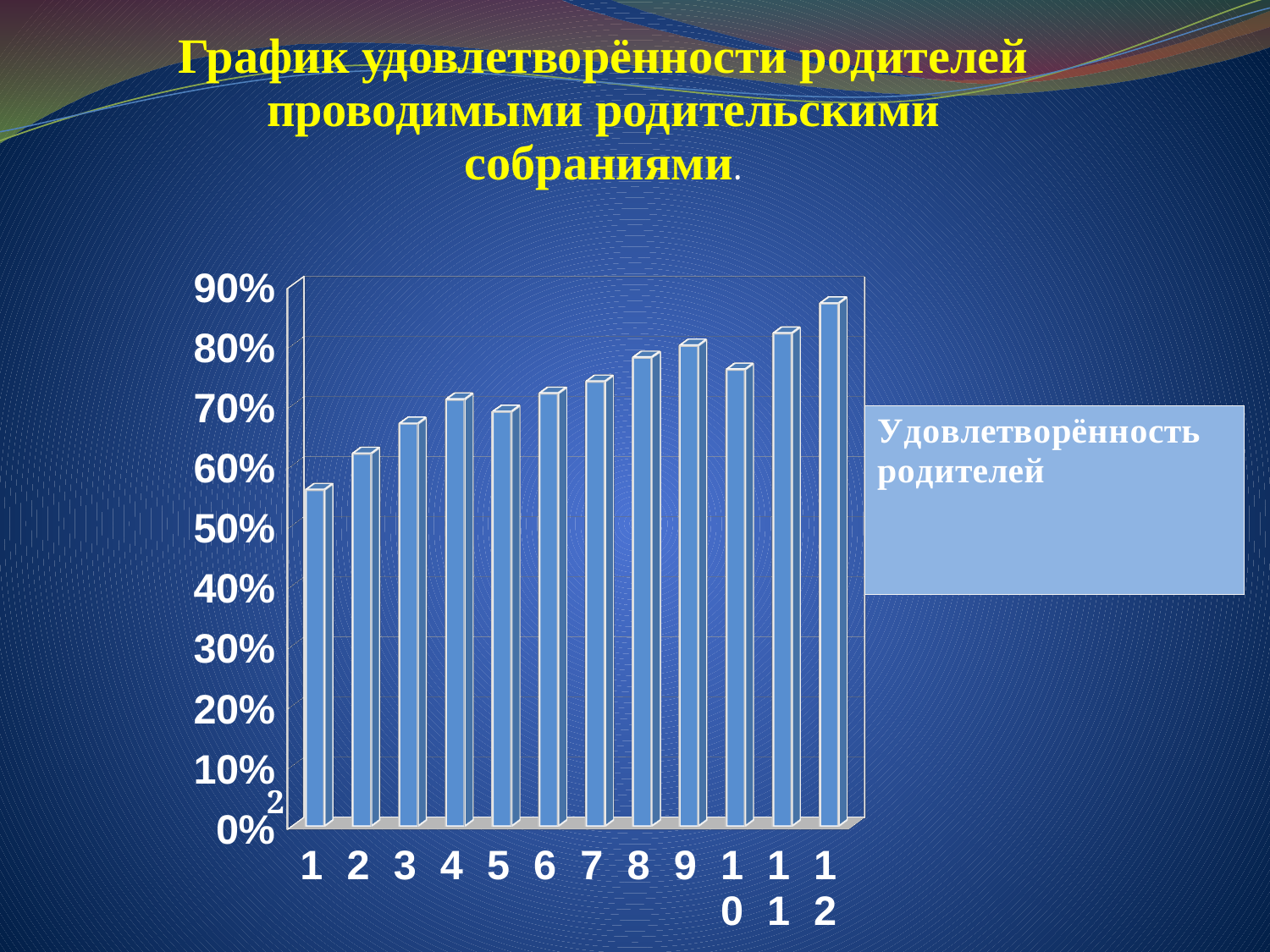
Is the value for category 12 greater or less than 80%? greater Is the value for category 10 greater or less than 70%? greater Which category has the lowest bar? 1 What kind of chart is shown on the slide? bar chart How many series does the legend list? 1 Is the value for category 1 greater or less than 60%? less Which is larger, the value for category 11 or the value for category 10? category 11 What series name is shown in the legend? Удовлетворённость родителей Which category has the highest bar? 12 How many categories are plotted along the x axis? 12 Do the values generally rise or fall from category 1 to category 12? rise